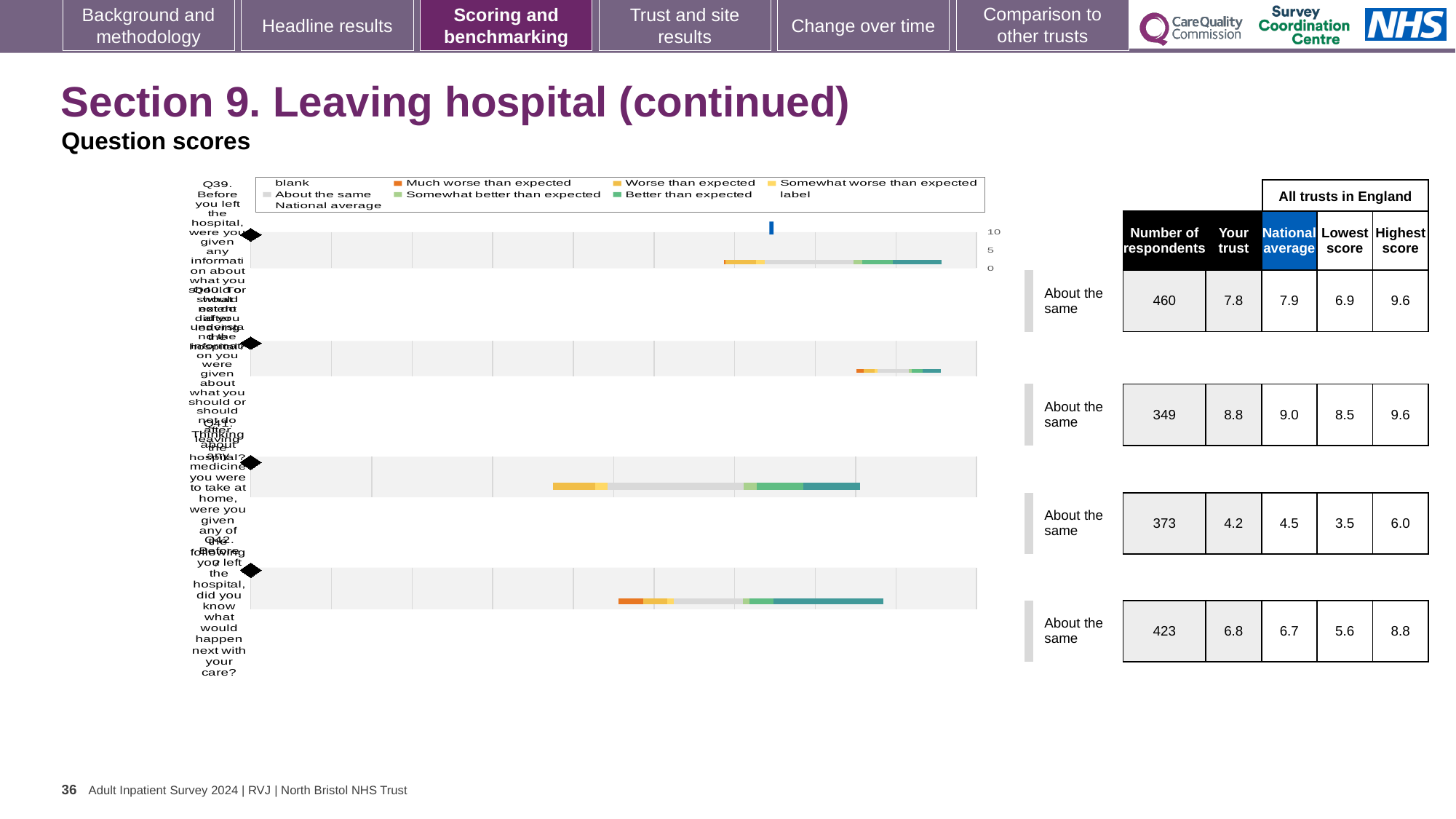
In the table, what is the 'Number of respondents' in the second row (aligned with the Q40 chart)? 349 In the chart legend, what colour represents 'Much worse than expected'? orange What kind of chart is used for the Q39 to Q42 question scores on this slide? bar chart What benchmark label is shown beside each of the four question charts? About the same In the third table row (Q41), what is the difference between the 'Highest score' and the 'Lowest score'? 2.5 In the table, what is the 'Your trust' score in the first row (aligned with the Q39 chart)? 7.8 In the first table row (Q39), which is larger: the 'Your trust' score or the 'National average' score? National average Which table row has the lowest 'Your trust' score? the third row (4.2) In the table, what is the 'National average' score in the first row (aligned with the Q39 chart)? 7.9 Which table row has the highest 'Your trust' score? the second row (8.8) How many question charts (Q39 to Q42) are shown on the slide? 4 In the table, what is the 'Highest score' in the fourth row (aligned with the Q42 chart)? 8.8